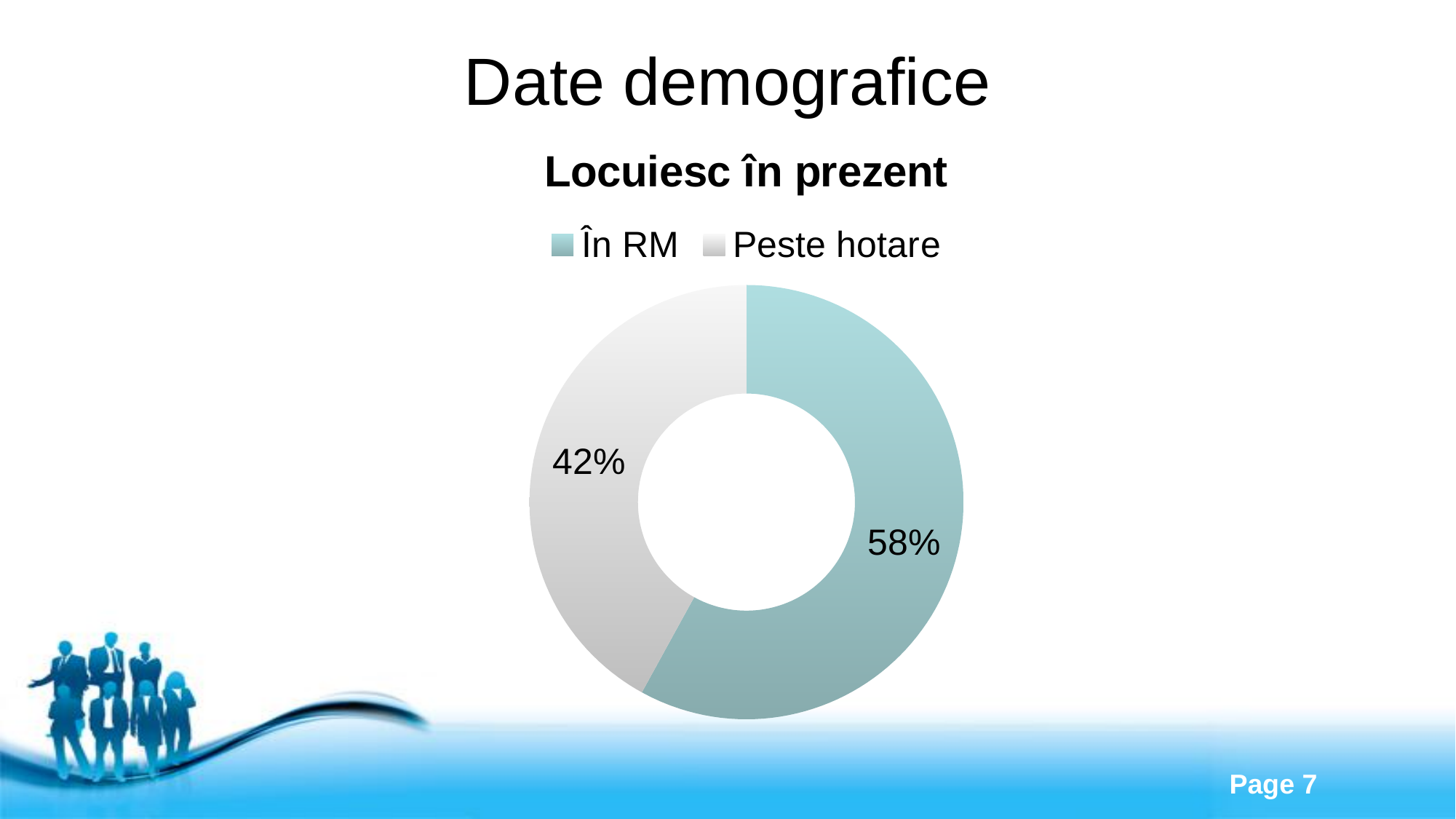
Which category has the smaller share of the chart? Peste hotare What share of the pie does the Peste hotare slice represent? 42% How many entries does the legend list? 2 Is the share for În RM larger or smaller than the share for Peste hotare? larger What percentage of respondents currently live abroad (Peste hotare)? 42% What percentage of respondents currently live in RM (În RM)? 58% What is the title of the chart? Locuiesc în prezent Which colour represents În RM in the chart? Teal (blue-green) Which category has the larger share: În RM or Peste hotare? În RM What is the difference in percentage points between În RM and Peste hotare? 16 What kind of chart is shown on the slide? Pie chart (doughnut) How many categories are shown in the chart? 2